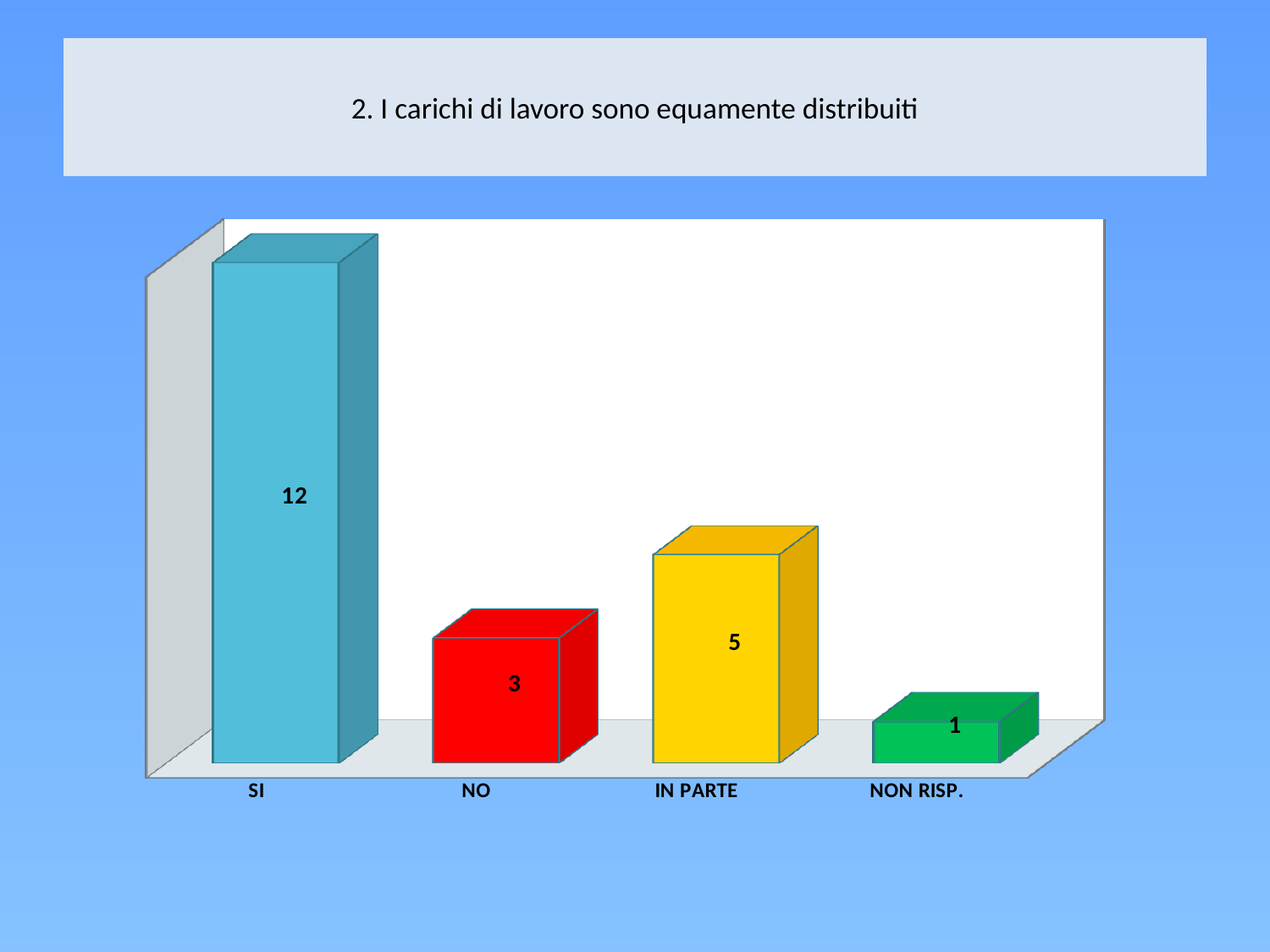
Which category has the highest value? SI What is the difference between the values for SI and IN PARTE? 7 What is the difference between the values for IN PARTE and NO? 2 Which category has the lowest value? NON RISP. What is the value for NO? 3 How many categories are shown on the x axis? 4 What is the value for SI? 12 What is the title of the slide above the chart? 2. I carichi di lavoro sono equamente distribuiti What is the value for IN PARTE? 5 Which is larger, the value for NO or the value for IN PARTE? IN PARTE What is the value for NON RISP.? 1 What kind of chart is shown on the slide? Bar chart